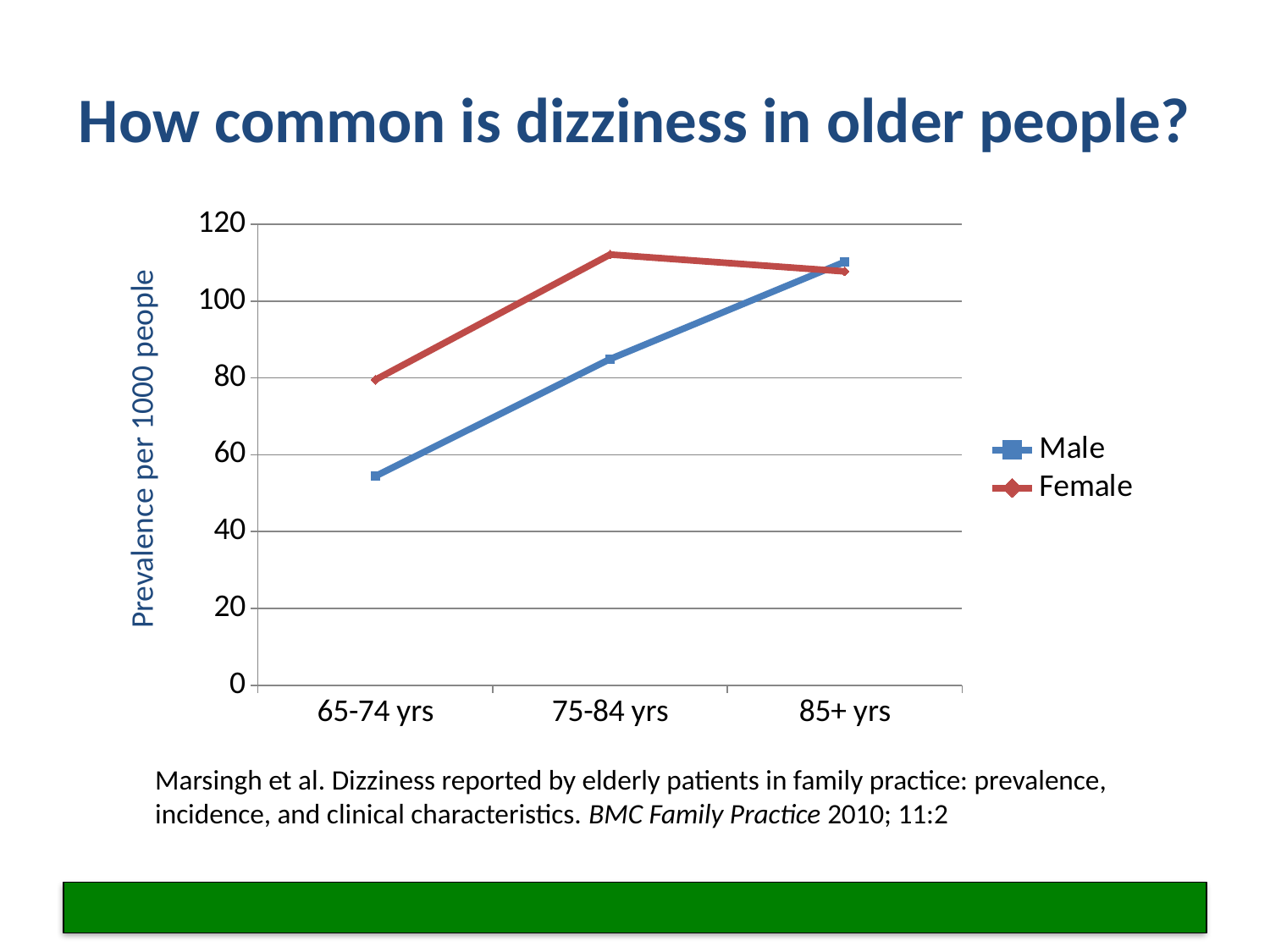
How many series does the legend list? 2 For the 75-84 yrs group, which series has the higher value, Male or Female? Female Is the Male value for 65-74 yrs greater or less than 60? less Is the Female value for 65-74 yrs greater or less than 100? less For the 65-74 yrs group, which series has the higher value, Male or Female? Female Which age group has the lowest Male value? 65-74 yrs Is the Male value for 85+ yrs greater or less than 100? greater How many age groups are shown on the x axis? 3 What kind of chart is shown on the slide? line chart Does the Male line rise or fall from 65-74 yrs to 85+ yrs? rise What is the title of the y axis? Prevalence per 1000 people